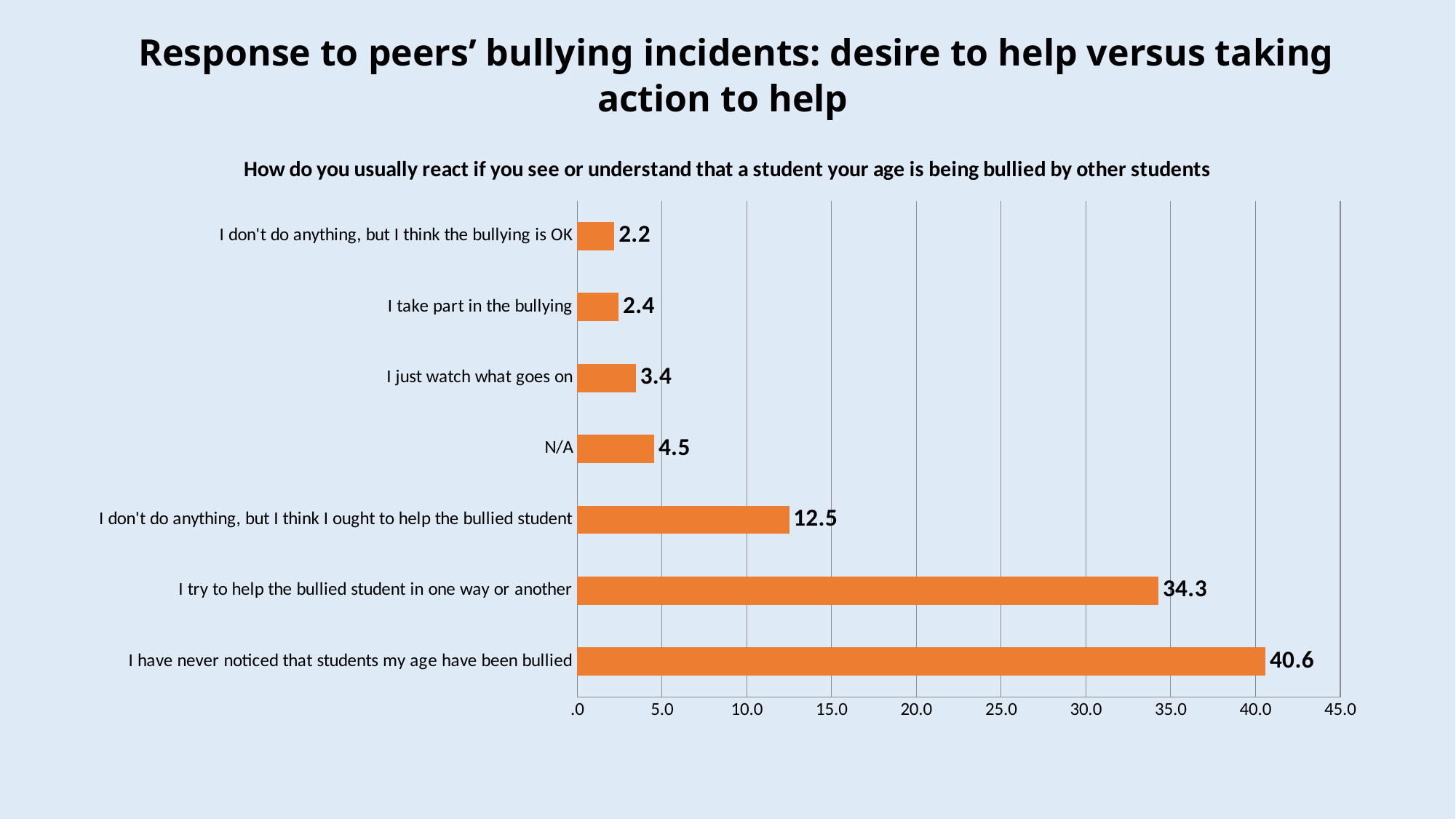
Which category has the lowest value? I don't do anything, but I think the bullying is OK What is the value for "I just watch what goes on"? 3.4 Which category has the highest value? I have never noticed that students my age have been bullied What kind of chart is shown on the slide? bar chart How many categories are shown in the chart? 7 Which is larger: the value for "I take part in the bullying" or the value for "I just watch what goes on"? I just watch what goes on What is the value for "N/A"? 4.5 What is the difference between the values for "I don't do anything, but I think I ought to help the bullied student" and "N/A"? 8.0 What is the value for "I try to help the bullied student in one way or another"? 34.3 What is the chart's title? How do you usually react if you see or understand that a student your age is being bullied by other students What is the difference between the values for "I have never noticed that students my age have been bullied" and "I try to help the bullied student in one way or another"? 6.3 Is the value for "I don't do anything, but I think I ought to help the bullied student" greater or less than 10.0? greater